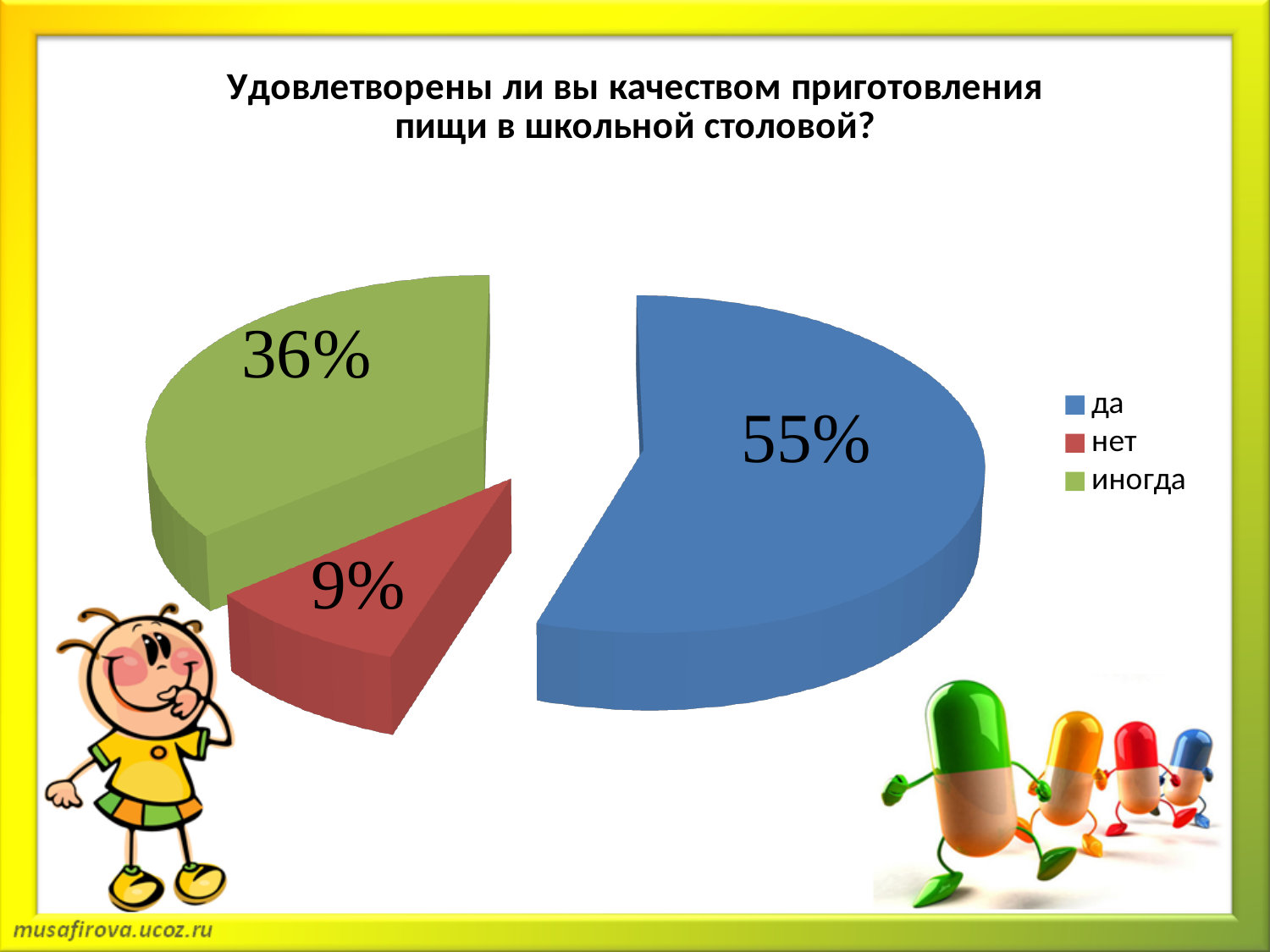
What is the difference in percentage points between "иногда" and "нет"? 27 What percentage of respondents answered "да"? 55% Which is larger, the share for "нет" or the share for "иногда"? иногда What percentage of respondents answered "нет"? 9% What percentage of respondents answered "иногда"? 36% Which answer has the largest share of the pie? да How many entries does the legend list? 3 How many slices does the pie chart have? 3 Which answer has the smallest share of the pie? нет What kind of chart is shown on the slide? pie chart What is the difference in percentage points between "да" and "иногда"? 19 What colour is the slice for "нет"? red